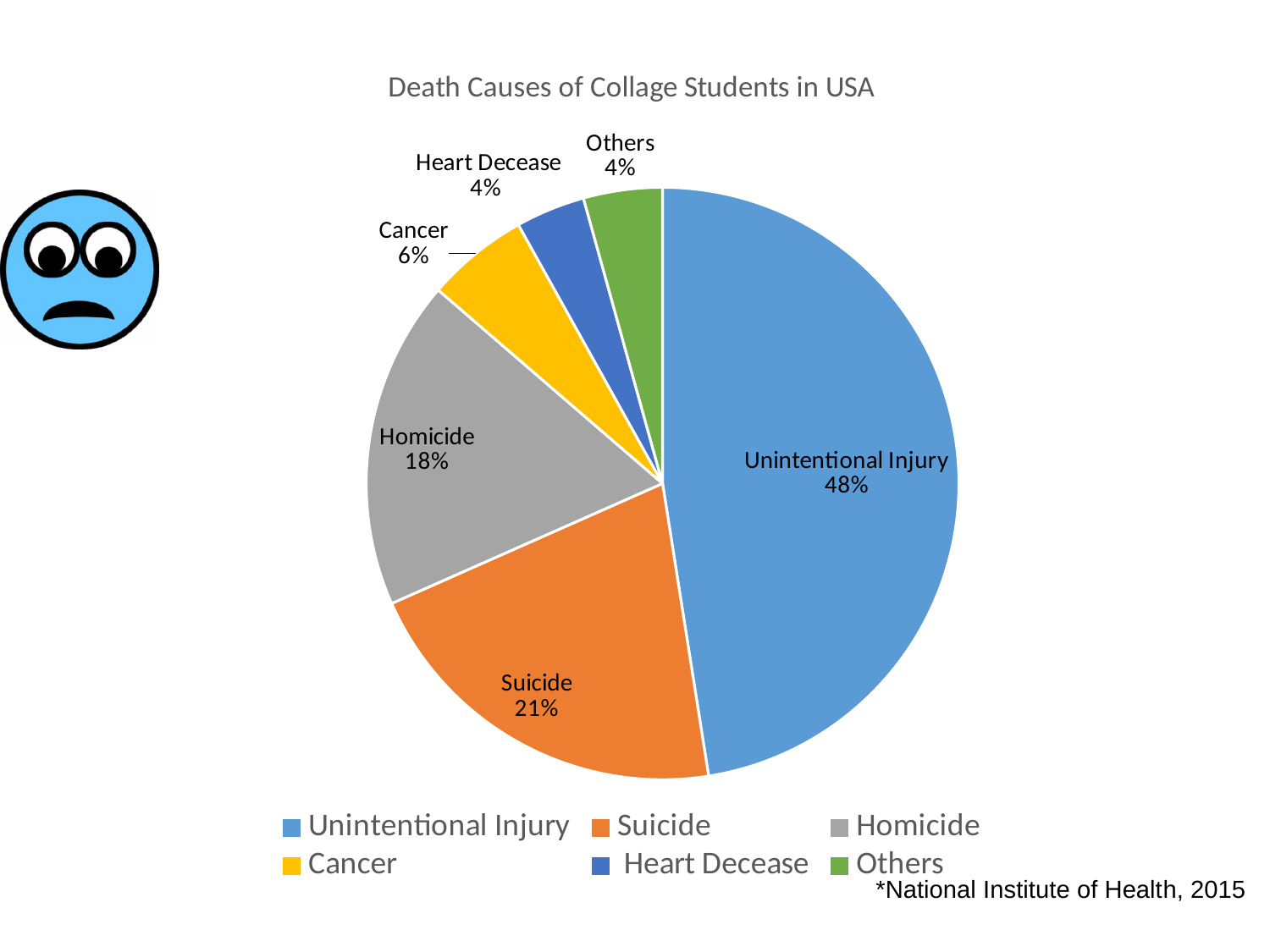
What percentage of the pie is Homicide? 18% What is the title of the chart? Death Causes of Collage Students in USA What percentage of the pie is Unintentional Injury? 48% Which is larger, the share for Suicide or the share for Homicide? Suicide What is the difference in percentage points between Homicide and Cancer? 12 What colour is the Cancer slice? Yellow What percentage of the pie is Cancer? 6% Which cause has the largest share of the pie? Unintentional Injury What kind of chart is shown on the slide? Pie chart What is the difference in percentage points between Unintentional Injury and Suicide? 27 How many slices does the pie chart have? 6 What percentage of the pie is Suicide? 21%